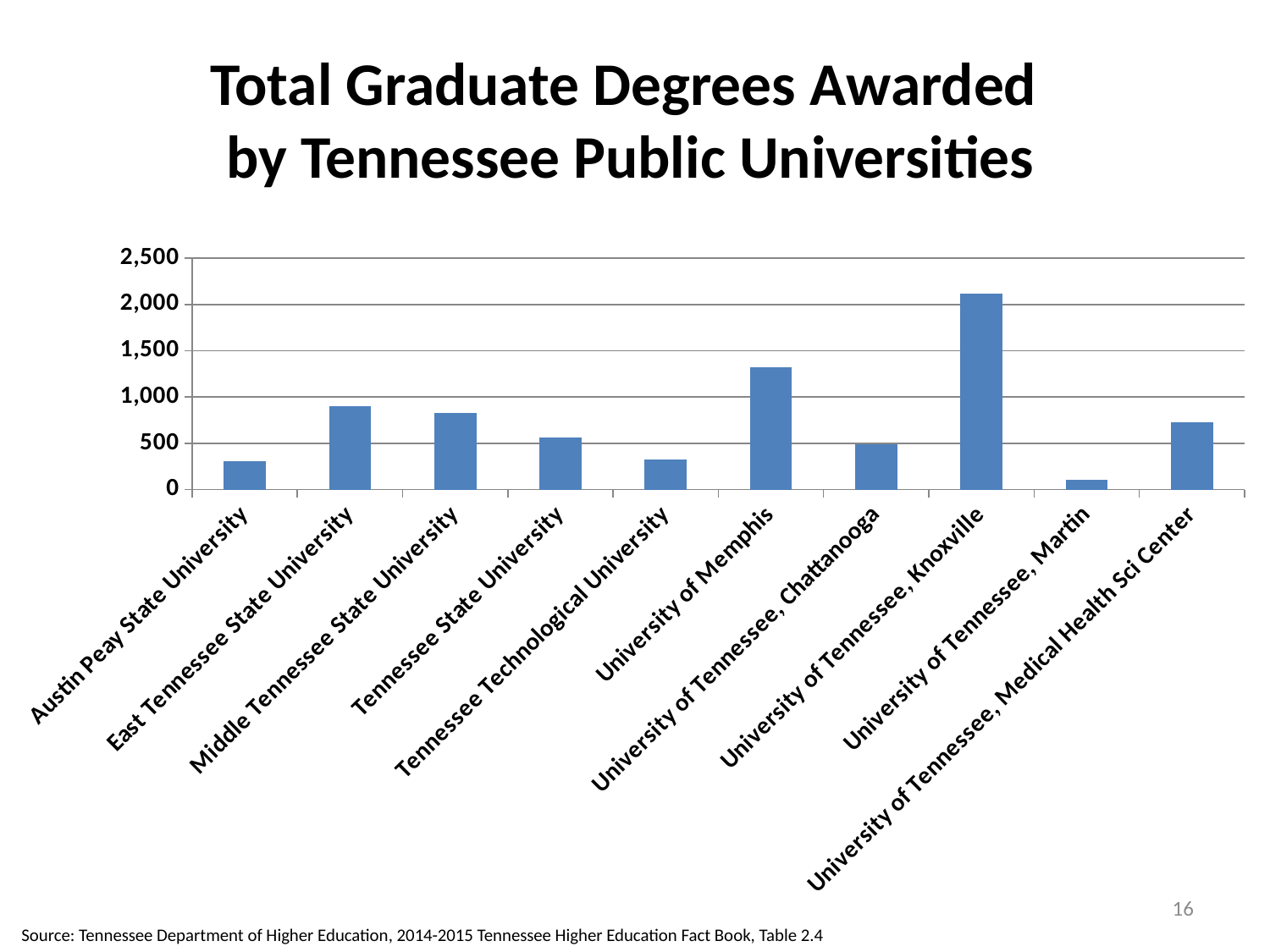
Is the value for University of Tennessee, Medical Health Sci Center greater or less than 500? greater Is the value for University of Memphis greater or less than 1,000? greater Which awarded more graduate degrees, Tennessee State University or Tennessee Technological University? Tennessee State University Which awarded more graduate degrees, University of Memphis or East Tennessee State University? University of Memphis Which university awarded the most graduate degrees? University of Tennessee, Knoxville Is the value for University of Tennessee, Knoxville greater or less than 2,000? greater How many universities are shown on the x axis? 10 Which university awarded the fewest graduate degrees? University of Tennessee, Martin What is the title of the chart? Total Graduate Degrees Awarded by Tennessee Public Universities What type of chart is shown on the slide? bar chart